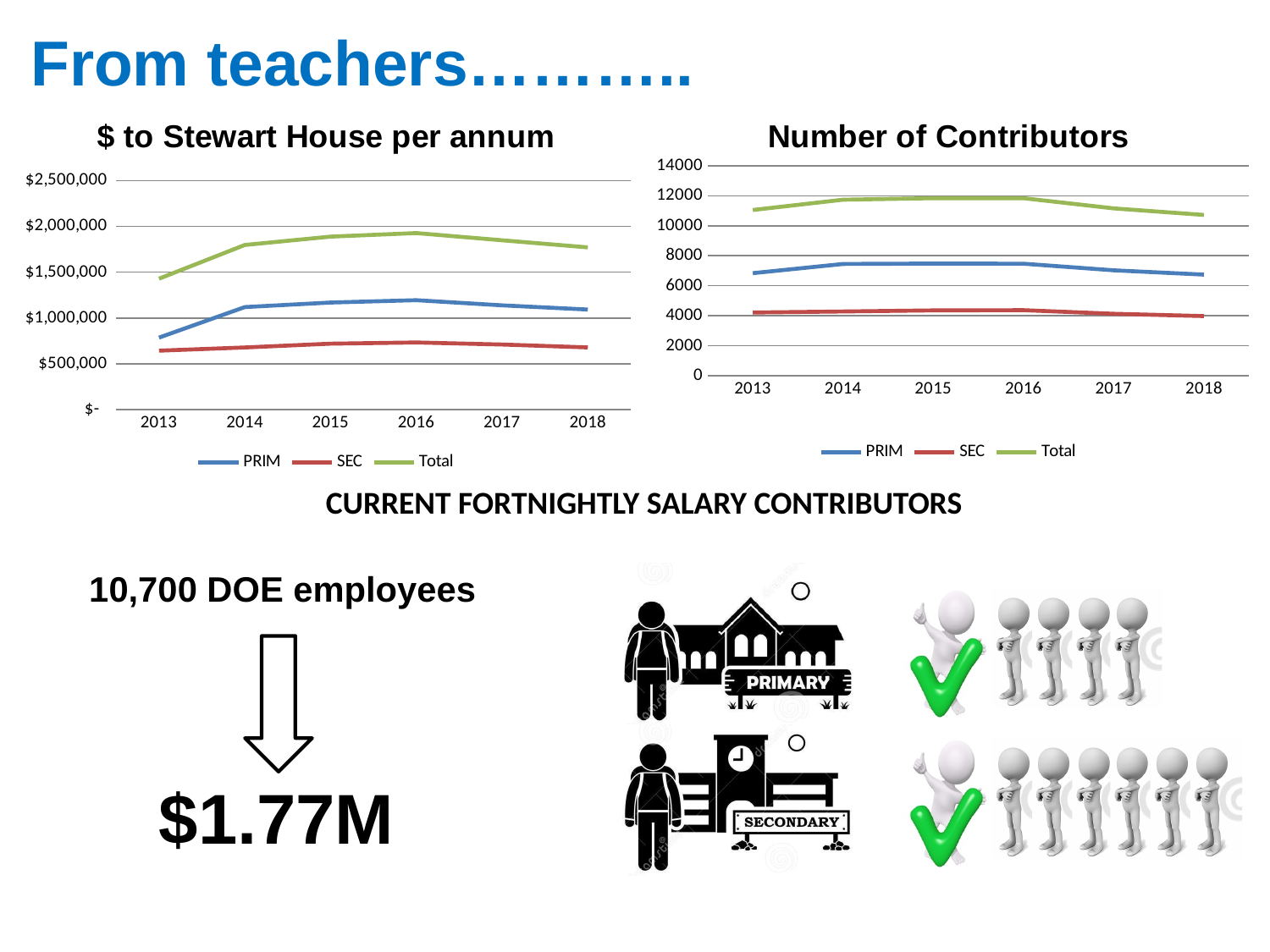
In the "$ to Stewart House per annum" chart, in which year is the Total series highest? 2016 In the "Number of Contributors" chart, which is larger in 2018, Total or PRIM? Total How many series does the legend of the "Number of Contributors" chart list? 3 What kind of chart is the "$ to Stewart House per annum" chart? line chart In the "Number of Contributors" chart, is the Total value for 2013 greater or less than 10000? greater In the "$ to Stewart House per annum" chart, is the Total value for 2016 greater or less than $2,000,000? less In the "$ to Stewart House per annum" chart, is the PRIM value for 2013 greater or less than $1,000,000? less In the "$ to Stewart House per annum" chart, in which year is the Total series lowest? 2013 What is the title of the chart on the right of the slide? Number of Contributors How many years are shown on the x axis of the "$ to Stewart House per annum" chart? 6 In the "$ to Stewart House per annum" chart, which is larger in 2016, PRIM or SEC? PRIM